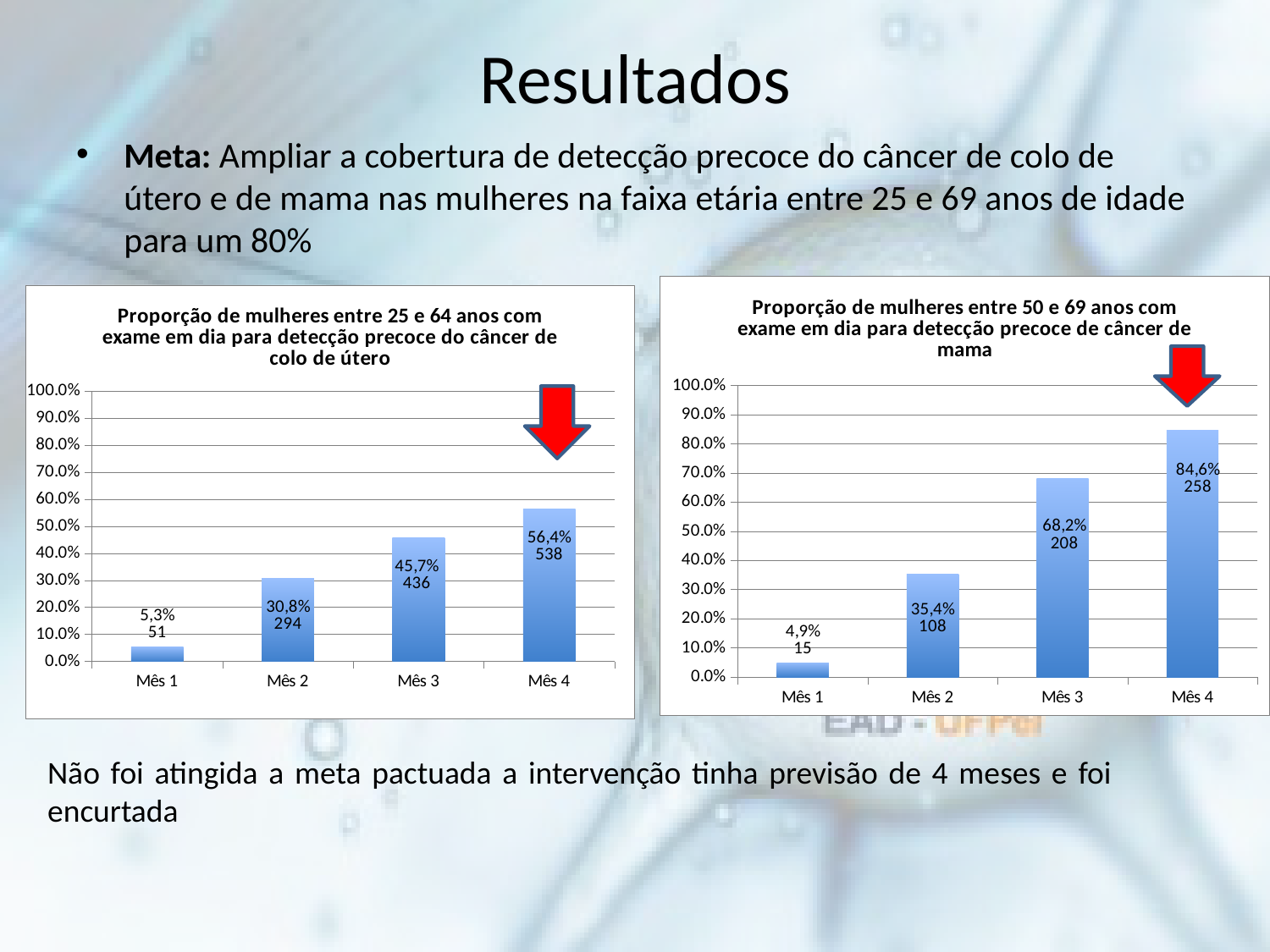
What type of chart is used in the right chart (câncer de mama)? Bar chart In the left chart (colo de útero), which month has the lowest value? Mês 1 In the right chart (câncer de mama), what count is printed for Mês 1? 15 In the left chart (colo de útero), do the values rise or fall from Mês 1 to Mês 4? Rise In the right chart (câncer de mama), which month has the highest value? Mês 4 Which is larger: the Mês 4 value in the left chart (colo de útero) or the Mês 4 value in the right chart (câncer de mama)? Right chart (câncer de mama), 84,6% In the left chart (colo de útero), what count is printed under the percentage for Mês 2? 294 In the left chart (colo de útero), what percentage is shown for Mês 4? 56,4% In the right chart (câncer de mama), what percentage is shown for Mês 3? 68,2% In the right chart (câncer de mama), is the value for Mês 4 greater or less than 80.0%? greater How many months (categories) are plotted in the left chart (colo de útero)? 4 In the right chart (câncer de mama), what is the difference in counts between Mês 4 (258) and Mês 3 (208)? 50